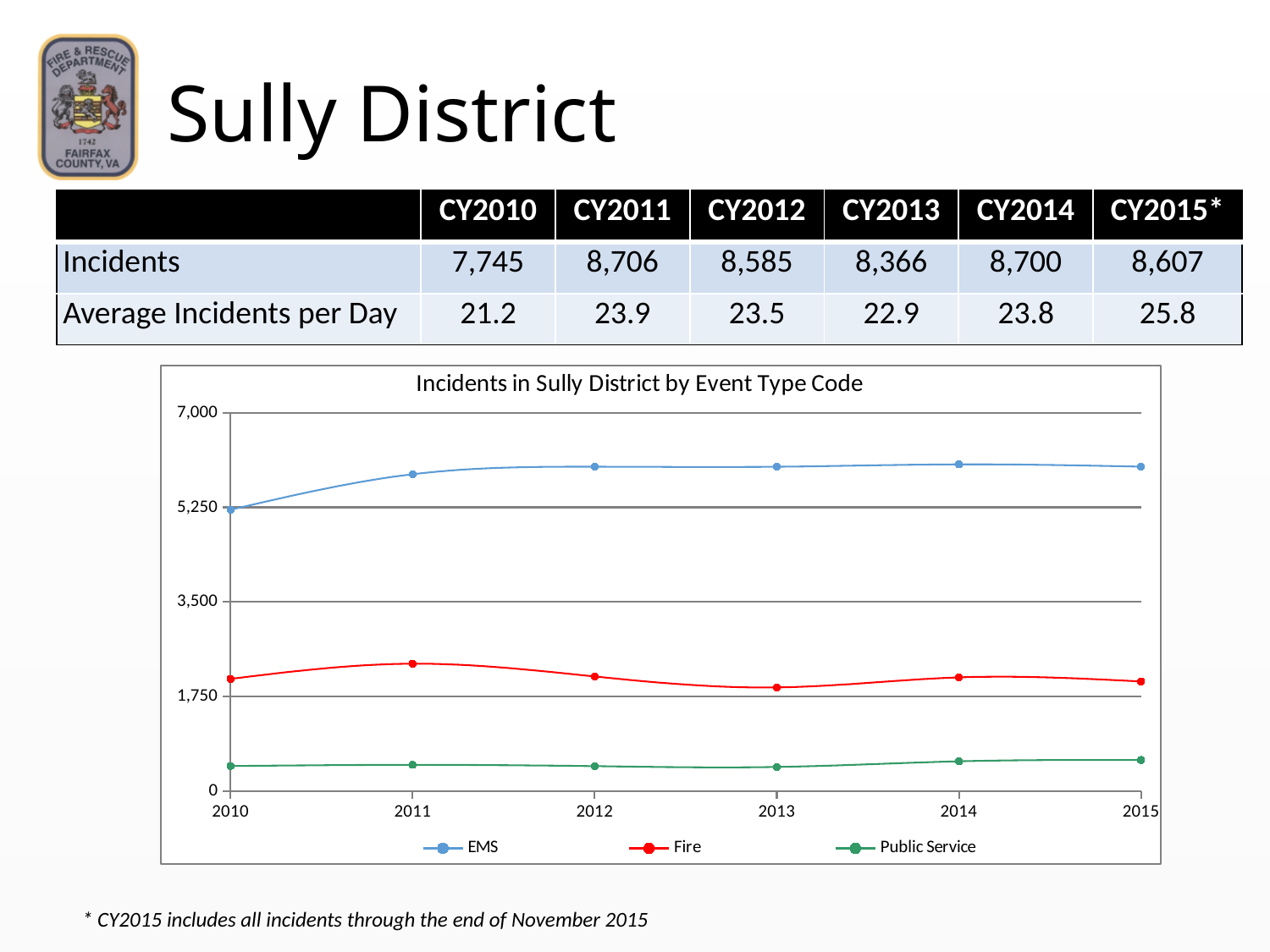
In which year does the Fire series reach its highest value? 2011 What kind of chart is "Incidents in Sully District by Event Type Code"? line chart Does the EMS line rise or fall from 2010 to 2011? rise How many years are plotted along the x axis of the chart? 6 Which series has the lowest values across all years in the chart? Public Service What is the title of the chart on the slide? Incidents in Sully District by Event Type Code Is the value for EMS in 2012 greater or less than 5,250? greater In 2014, which series is larger, EMS or Fire? EMS Is the value for Fire in 2011 greater or less than 3,500? less Is the value for Public Service in 2015 greater or less than 1,750? less Which series has the highest values across all years in the chart? EMS How many series does the legend of the chart list? 3